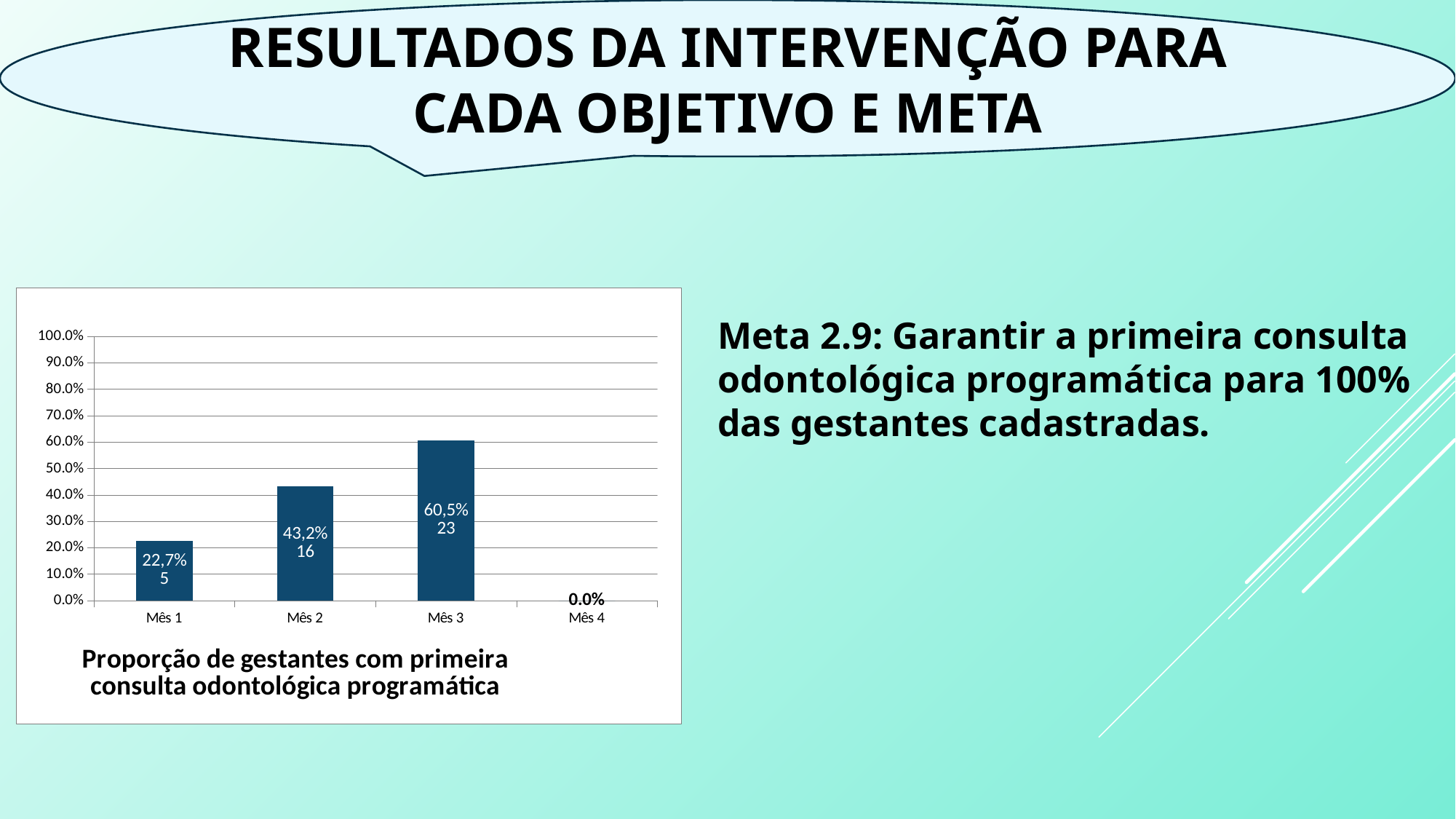
What is the value shown for Mês 4? 0.0% How many months are shown on the x axis? 4 Which is larger, the value for Mês 2 or the value for Mês 1? Mês 2 What is the value shown for Mês 3? 60,5% Which month has the highest proportion? Mês 3 Which month has the lowest proportion? Mês 4 What is the title of the chart? Proporção de gestantes com primeira consulta odontológica programática What kind of chart is shown? bar chart What is the value shown for Mês 1? 22,7% What count is printed on the bar for Mês 2? 16 Is the value for Mês 3 greater or less than 50.0%? greater What is the difference in percentage points between Mês 3 and Mês 2? 17,3